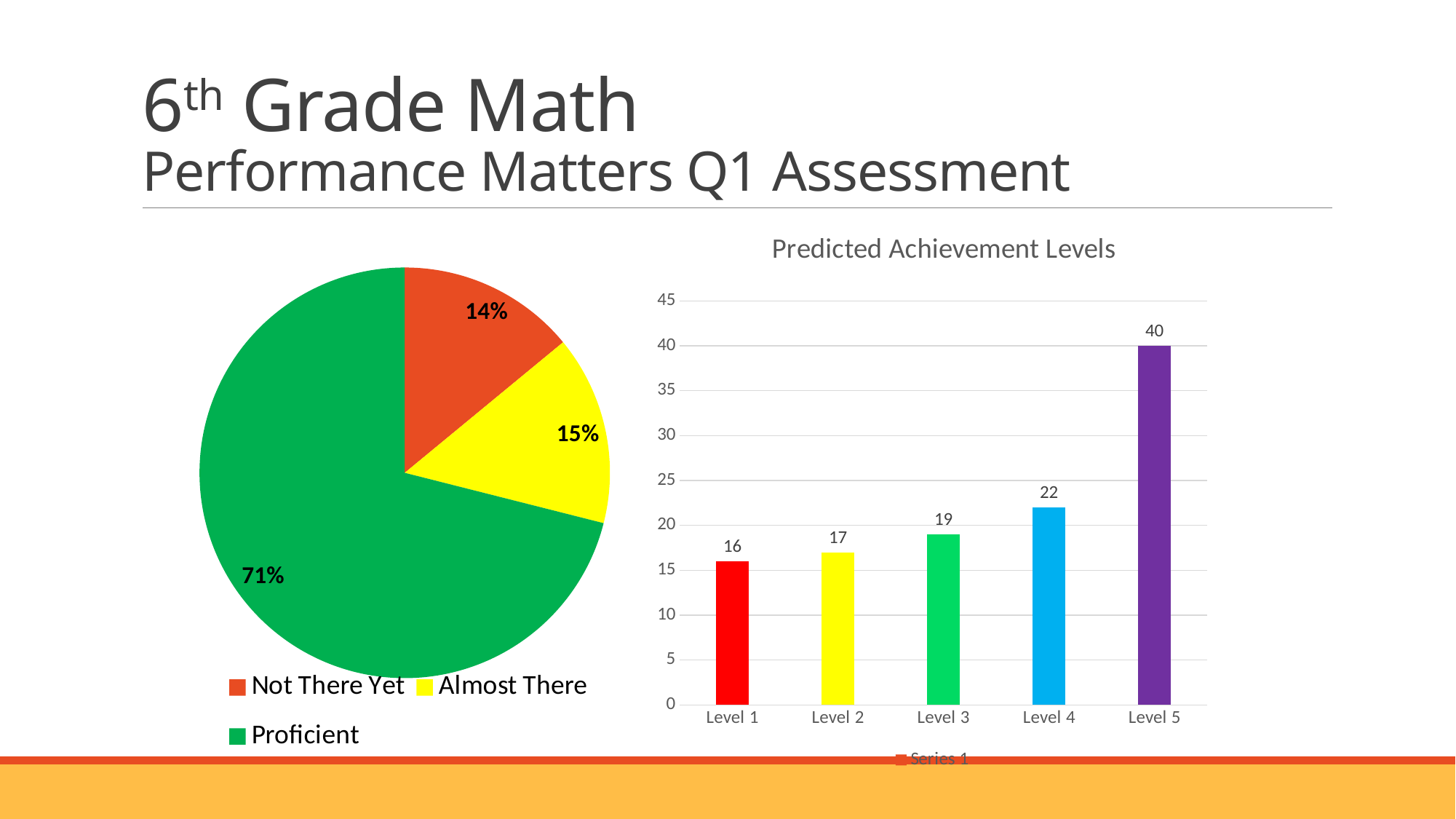
In the pie chart on the left, which category has the largest slice? Proficient In the pie chart on the left, what percentage is shown for Almost There? 15% In the pie chart on the left, what percentage is shown for Proficient? 71% In the Predicted Achievement Levels chart, what is the difference between Level 5 and Level 4? 18 In the pie chart on the left, what percentage is shown for Not There Yet? 14% What kind of chart is the Predicted Achievement Levels chart? bar chart In the Predicted Achievement Levels chart, which level has the lowest value? Level 1 In the Predicted Achievement Levels chart, which is larger, Level 2 or Level 4? Level 4 In the pie chart on the left, how many slices are there? 3 In the Predicted Achievement Levels chart, what is the value for Level 5? 40 In the Predicted Achievement Levels chart, what is the value for Level 3? 19 In the Predicted Achievement Levels chart, do the values rise or fall from Level 1 to Level 5? rise